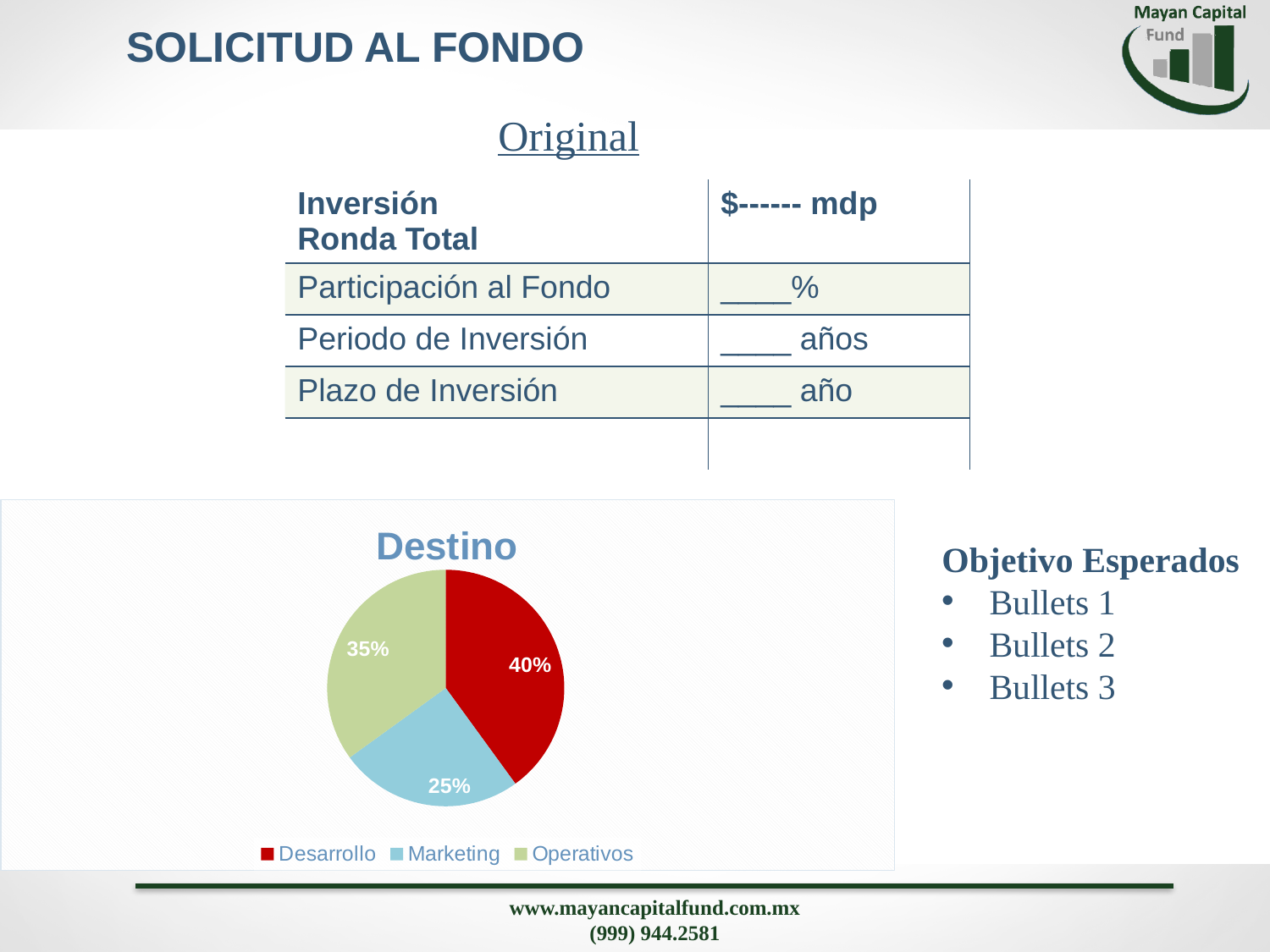
What share of the pie does Operativos have? 35% Which is larger, the Desarrollo slice or the Operativos slice? Desarrollo What colour is the Marketing slice in the pie chart? light blue What is the difference between the Desarrollo and Marketing shares? 15% What is the difference between the Operativos and Marketing shares? 10% What share of the pie does Marketing have? 25% What share of the pie does Desarrollo have? 40% How many categories does the pie chart have? 3 What is the title of the pie chart? Destino What kind of chart is shown under the title "Destino"? pie chart Which category has the smallest slice of the pie? Marketing Which category has the largest slice of the pie? Desarrollo